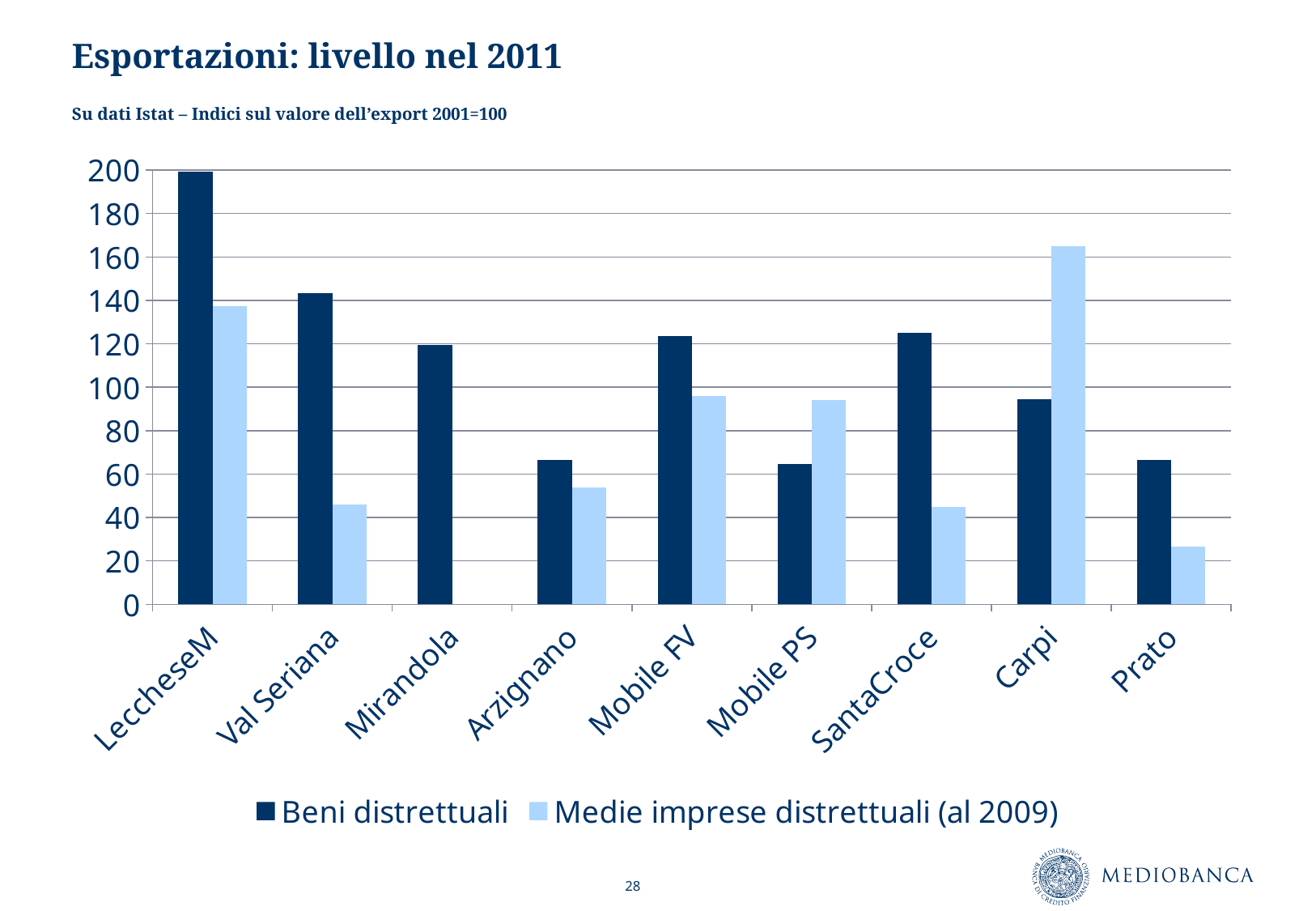
Is the Medie imprese distrettuali (al 2009) value for Val Seriana greater or less than 60? less Is the Beni distrettuali value for LeccheseM greater or less than 180? greater For Carpi, which series has the larger value: Beni distrettuali or Medie imprese distrettuali (al 2009)? Medie imprese distrettuali (al 2009) What kind of chart is shown on the slide? bar chart Which category has the lowest value for Medie imprese distrettuali (al 2009)? Prato Which category has the highest value for Beni distrettuali? LeccheseM Which category has the highest value for Medie imprese distrettuali (al 2009)? Carpi What is the title of the chart on the slide? Esportazioni: livello nel 2011 How many categories are shown on the x axis? 9 Is the Beni distrettuali value for Mobile FV greater or less than 100? greater Which is larger for Beni distrettuali: Val Seriana or Mirandola? Val Seriana How many series does the legend list? 2